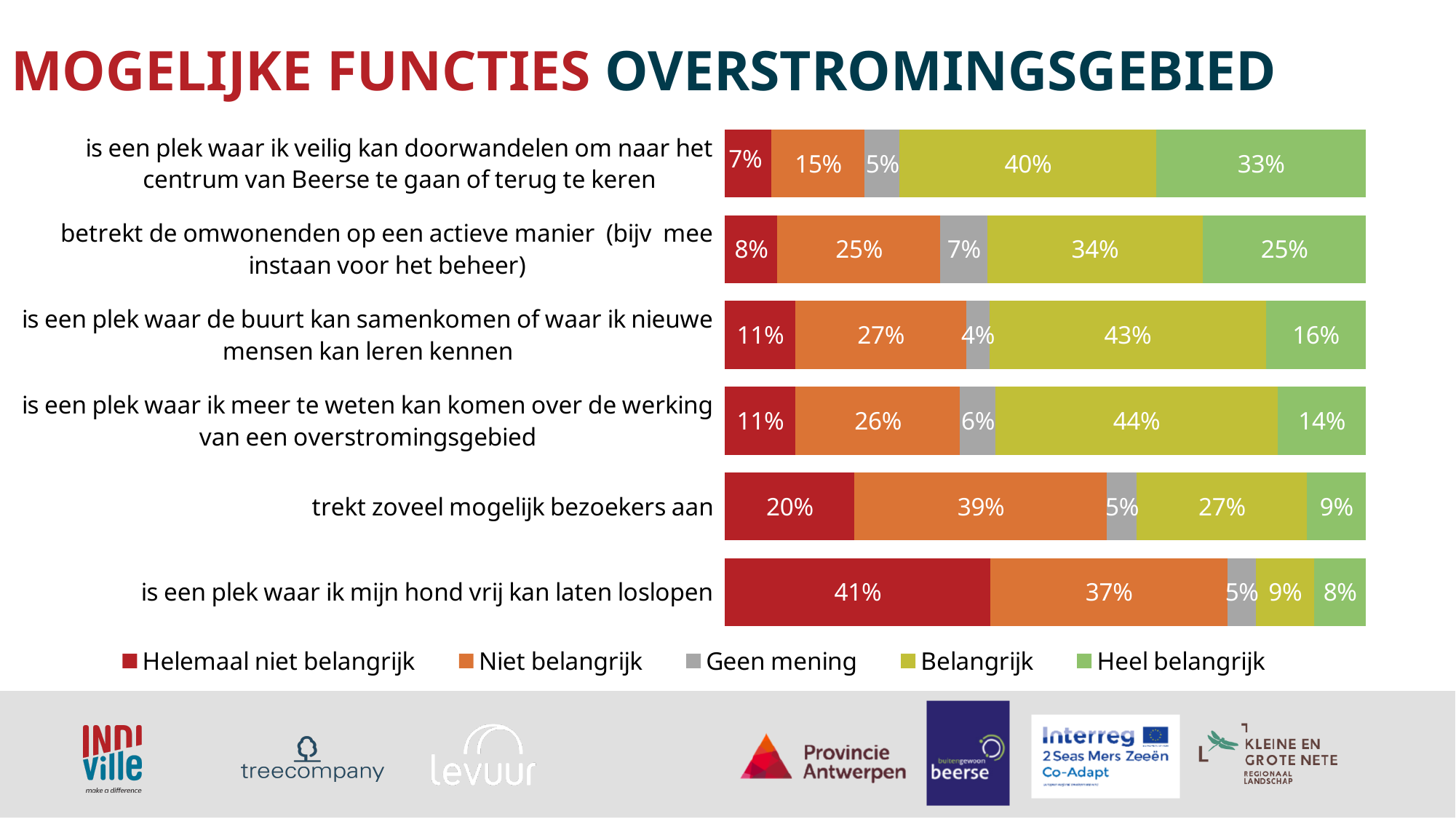
Which is larger: the 'Heel belangrijk' value for 'betrekt de omwonenden op een actieve manier' or for 'is een plek waar de buurt kan samenkomen of waar ik nieuwe mensen kan leren kennen'? betrekt de omwonenden op een actieve manier How many series does the legend list? 5 What is the 'Belangrijk' value for 'is een plek waar ik meer te weten kan komen over de werking van een overstromingsgebied'? 44% Which colour represents 'Geen mening' in the chart? Grey What is the 'Niet belangrijk' value for 'trekt zoveel mogelijk bezoekers aan'? 39% What is the difference between the 'Belangrijk' values for 'is een plek waar de buurt kan samenkomen of waar ik nieuwe mensen kan leren kennen' and 'trekt zoveel mogelijk bezoekers aan'? 16% How many categories (statements) are plotted in the chart? 6 What is the 'Heel belangrijk' value for 'is een plek waar ik veilig kan doorwandelen om naar het centrum van Beerse te gaan of terug te keren'? 33% What is the 'Helemaal niet belangrijk' value for 'is een plek waar ik mijn hond vrij kan laten loslopen'? 41% Which statement has the lowest 'Heel belangrijk' value? is een plek waar ik mijn hond vrij kan laten loslopen What kind of chart is shown on the slide? Stacked bar chart Which statement has the highest 'Helemaal niet belangrijk' value? is een plek waar ik mijn hond vrij kan laten loslopen